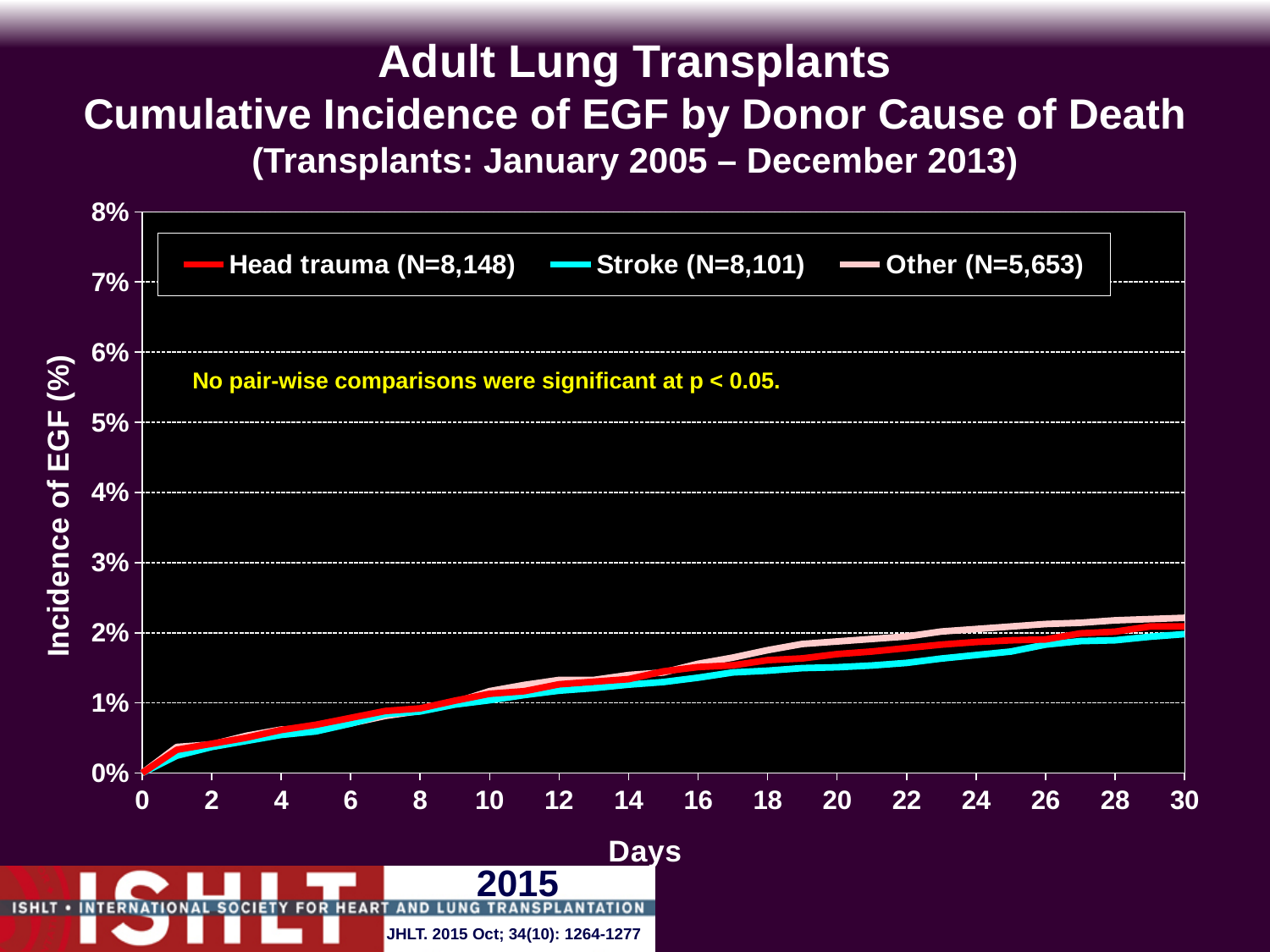
What kind of chart is shown on the slide? line chart How many tick labels are shown on the x axis? 16 At day 30, which series has the higher value, Other or Stroke? Other Is the value for Stroke at day 20 greater or less than 2%? less Is the value for Head trauma at day 4 greater or less than 1%? less What is the N shown in the legend for the Stroke series? 8,101 Do the cumulative incidence values rise or fall as the number of days increases? rise Is the value for Other at day 30 greater or less than 3%? less How many series does the legend list? 3 What is the label of the x axis? Days